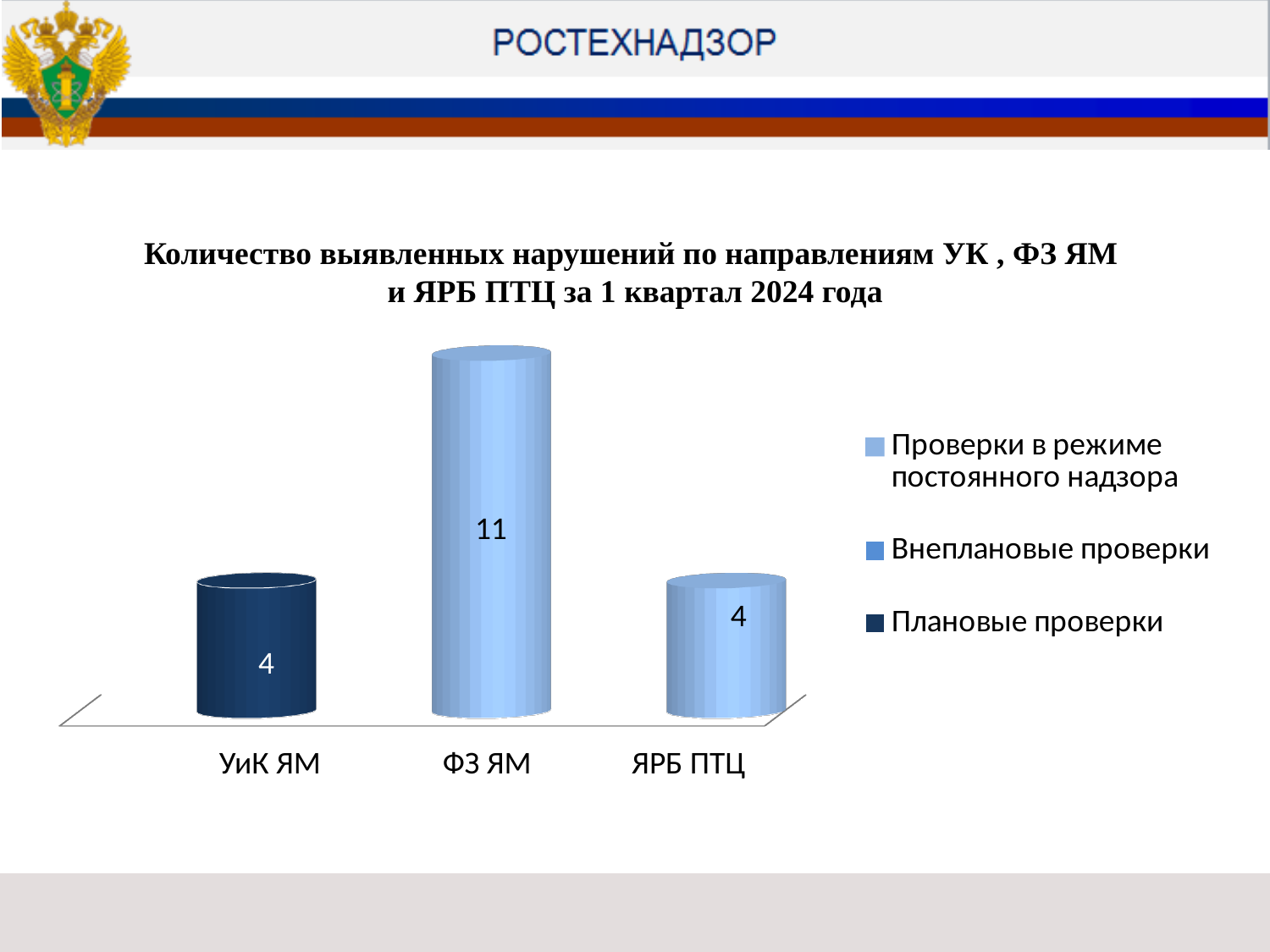
Which legend entry is shown in dark blue? Плановые проверки What is the value shown for УиК ЯМ? 4 How many series does the legend list? 3 How many categories are shown on the x axis? 3 Which is larger, the value for ФЗ ЯМ or the value for ЯРБ ПТЦ? ФЗ ЯМ What is the difference between the values for ФЗ ЯМ and ЯРБ ПТЦ? 7 What is the value shown for ФЗ ЯМ? 11 What is the title of the chart? Количество выявленных нарушений по направлениям УК , ФЗ ЯМ и ЯРБ ПТЦ за 1 квартал 2024 года Which category has the highest value? ФЗ ЯМ What kind of chart is shown on the slide? Bar chart What is the value shown for ЯРБ ПТЦ? 4 What is the difference between the values for ФЗ ЯМ and УиК ЯМ? 7